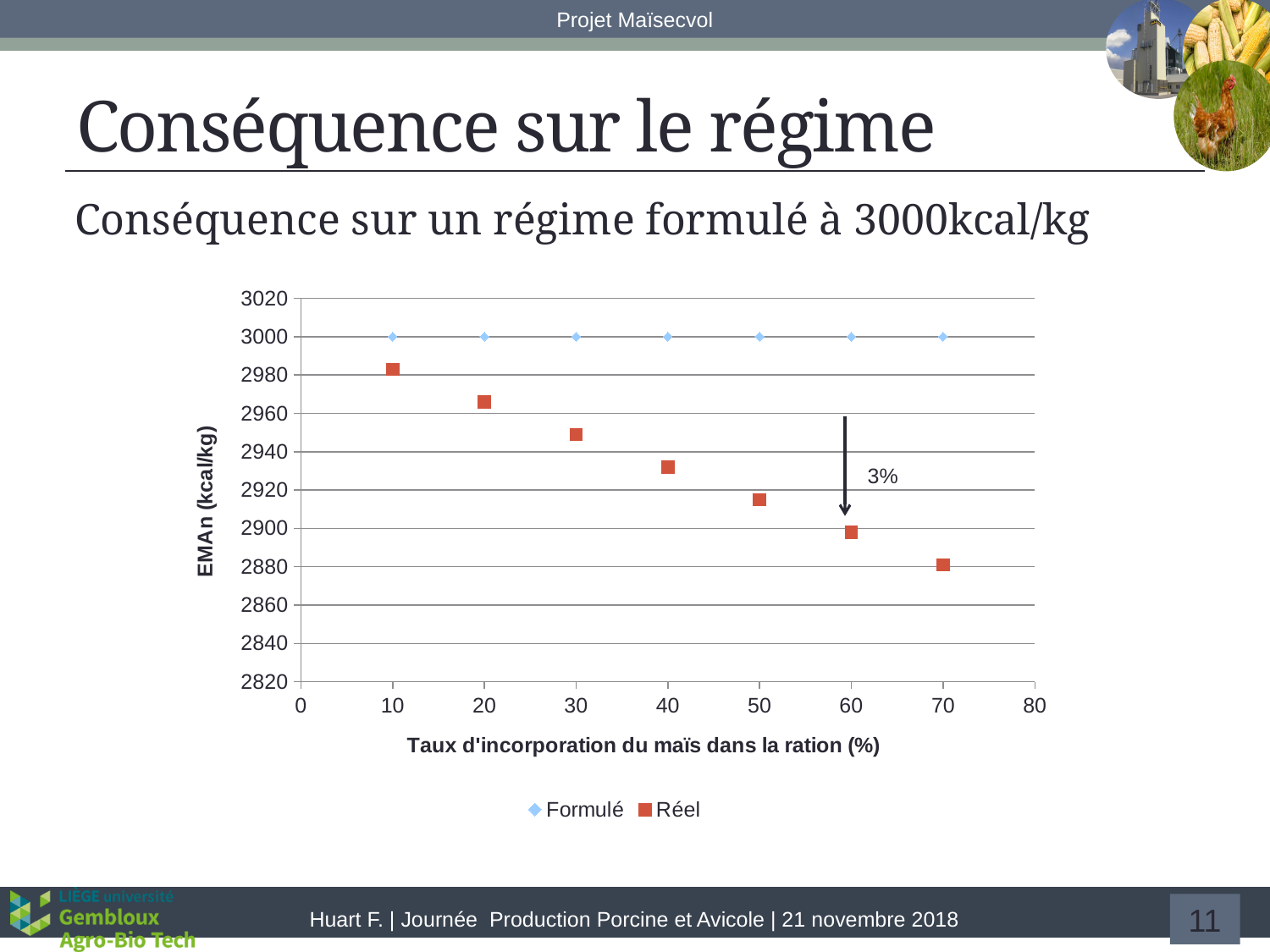
What is the label of the y axis? EMAn (kcal/kg) At which incorporation rate is the Réel value highest? 10 What is the EMAn value of the Formulé series at a 30% incorporation rate? 3000 At which incorporation rate is the Réel value lowest? 70 Is the Réel value at 40% incorporation greater or less than 2940? less What kind of chart is shown on the slide? scatter chart How many data points are plotted for the Réel series? 7 Do the Réel values rise or fall as the maize incorporation rate increases? fall At a 50% incorporation rate, which series has the larger value, Formulé or Réel? Formulé How many series does the legend list? 2 What is the EMAn value of the Formulé series at a 70% incorporation rate? 3000 Is the Réel value at 70% incorporation greater or less than 2900? less